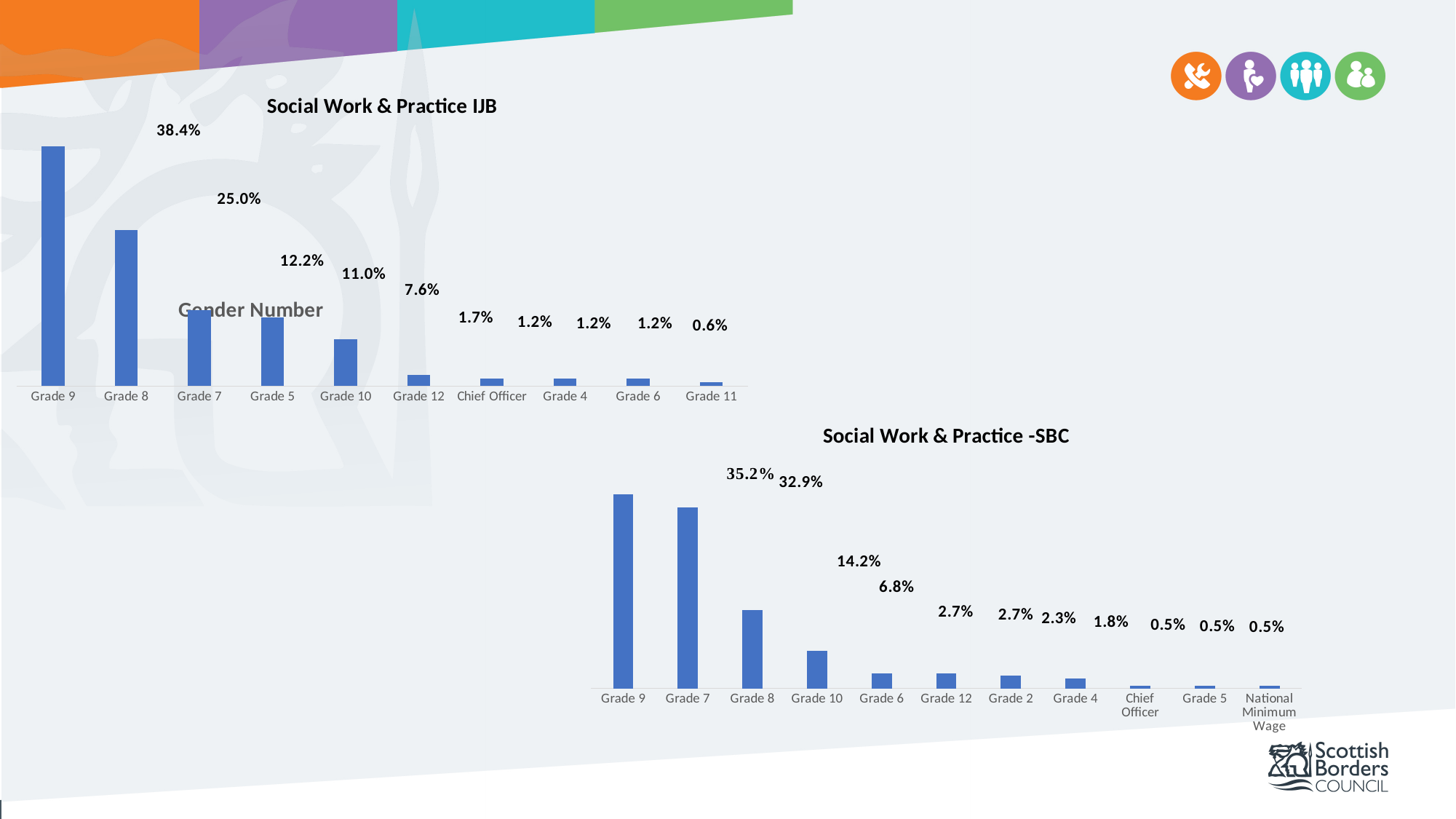
In the Social Work & Practice -SBC chart, what is the value for Grade 7? 32.9% In the Social Work & Practice IJB chart, how many categories are shown on the x axis? 10 In the Social Work & Practice -SBC chart, which grade has the highest value? Grade 9 In the Social Work & Practice -SBC chart, which is larger, the value for Grade 8 or the value for Grade 10? Grade 8 In the Social Work & Practice -SBC chart, what is the difference between the values for Grade 9 and Grade 7? 2.3% In the Social Work & Practice IJB chart, what is the difference between the values for Grade 9 and Grade 8? 13.4% What kind of chart is the Social Work & Practice -SBC chart? Bar chart In the Social Work & Practice IJB chart, which grade has the highest value? Grade 9 In the Social Work & Practice IJB chart, what is the value for Grade 8? 25.0% In the Social Work & Practice -SBC chart, how many categories are shown on the x axis? 11 In the Social Work & Practice IJB chart, what is the value for Grade 10? 11.0% In the Social Work & Practice IJB chart, which category has the lowest value? Grade 11